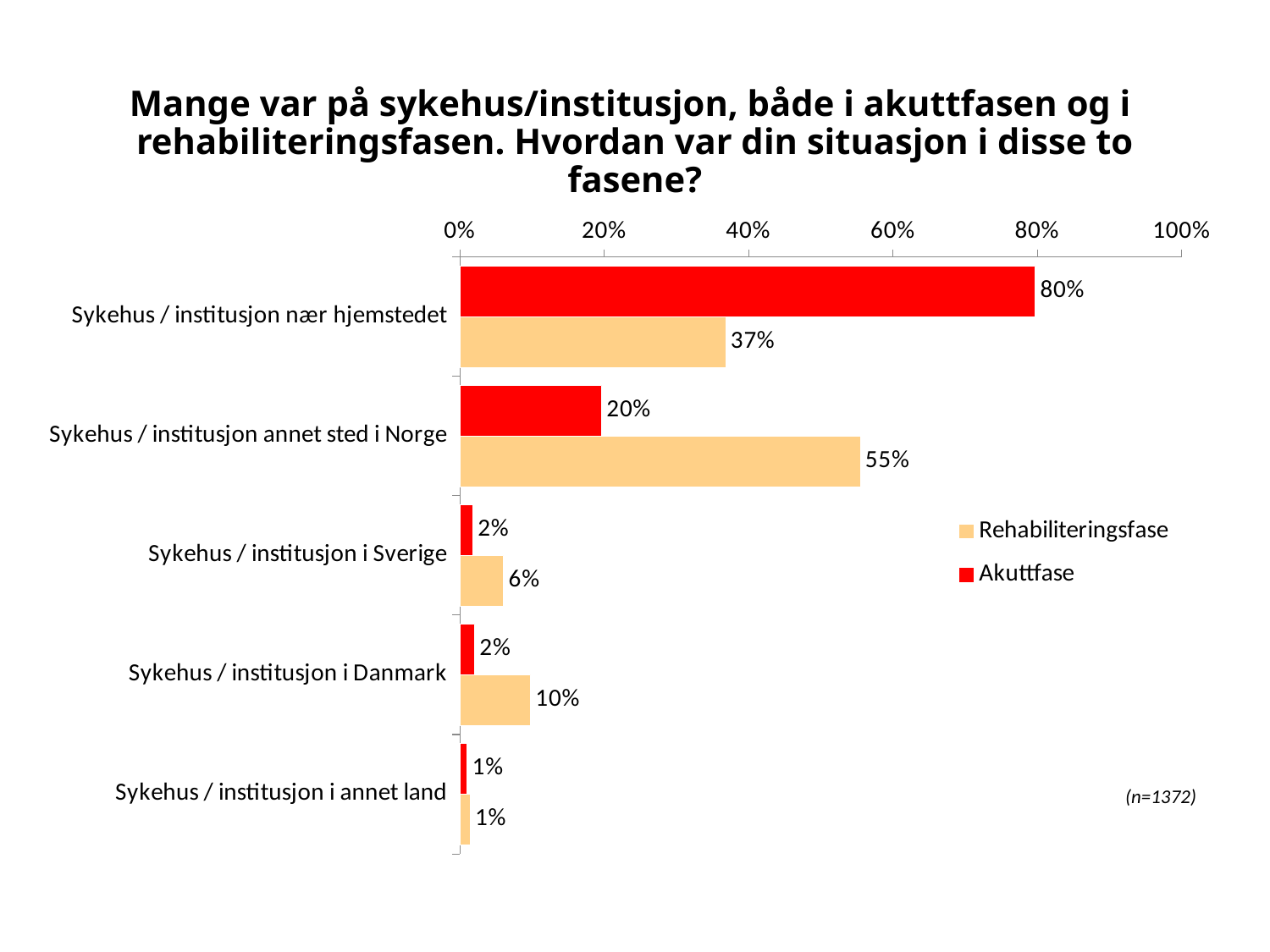
Is the Rehabiliteringsfase value for Sykehus / institusjon nær hjemstedet greater or less than 40%? less Which category has the lowest Rehabiliteringsfase value? Sykehus / institusjon i annet land For Sykehus / institusjon annet sted i Norge, which is larger: the Akuttfase value or the Rehabiliteringsfase value? Rehabiliteringsfase How many series does the legend list? 2 What is the Rehabiliteringsfase value for Sykehus / institusjon annet sted i Norge? 55% Which colour represents the Akuttfase series? red What kind of chart is shown on the slide? bar chart What is the difference between the Akuttfase and Rehabiliteringsfase values for Sykehus / institusjon nær hjemstedet? 43% How many categories are shown on the chart? 5 What is the Rehabiliteringsfase value for Sykehus / institusjon i Danmark? 10% Which category has the highest Akuttfase value? Sykehus / institusjon nær hjemstedet What is the Akuttfase value for Sykehus / institusjon nær hjemstedet? 80%